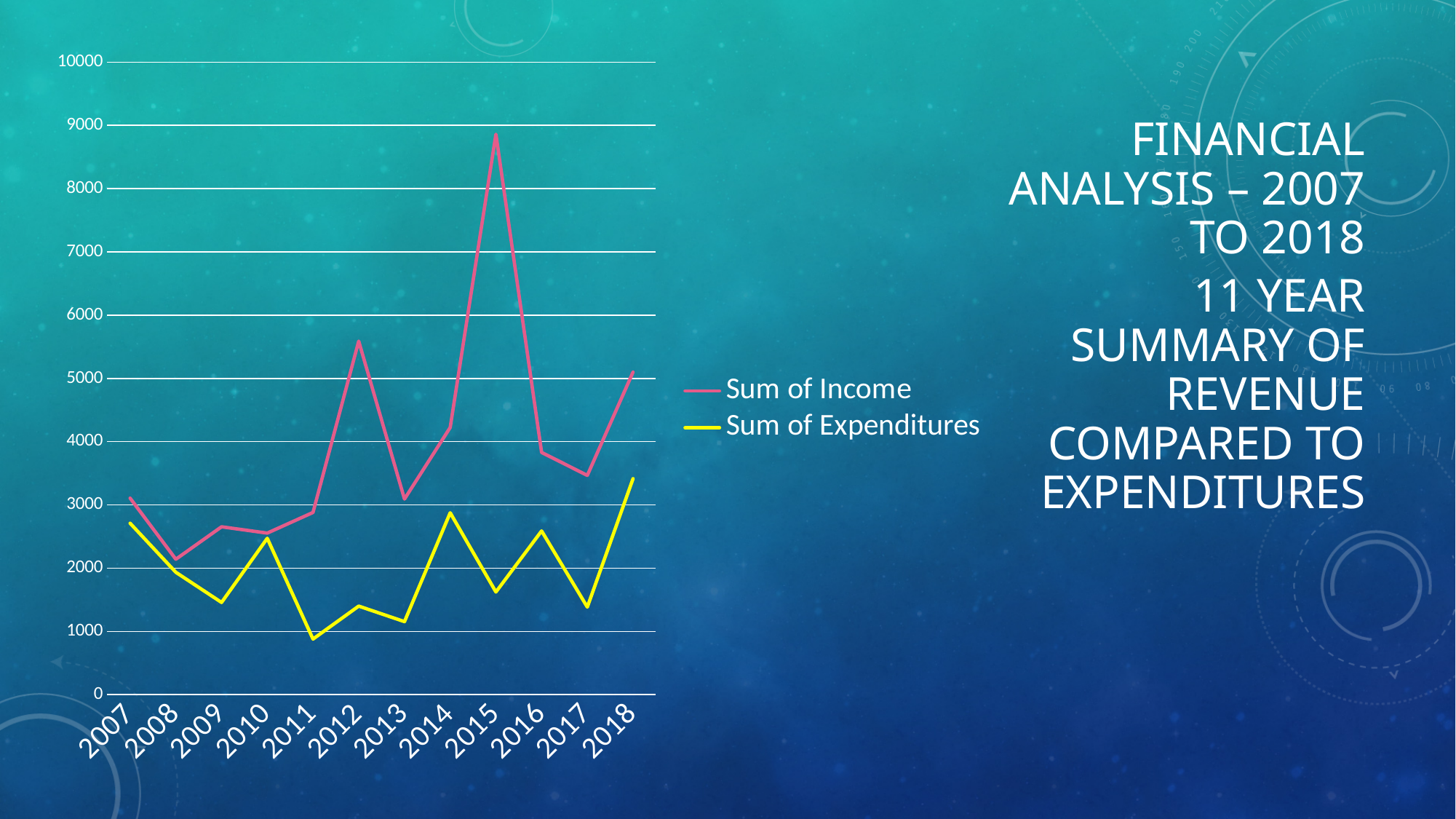
In which year is Sum of Income highest? 2015 How many series does the legend list? 2 How many years are plotted along the x axis? 12 Which is larger, Sum of Income in 2012 or Sum of Income in 2016? 2012 In which year is Sum of Income lowest? 2008 In which year is Sum of Expenditures lowest? 2011 Is the value for Sum of Income in 2015 greater or less than 8000? greater Is the value for Sum of Expenditures in 2011 greater or less than 1000? less What kind of chart is shown on the slide? Line chart In which year is Sum of Expenditures highest? 2018 What are the two entries in the chart legend? Sum of Income, Sum of Expenditures Does Sum of Income rise or fall from 2013 to 2015? Rise